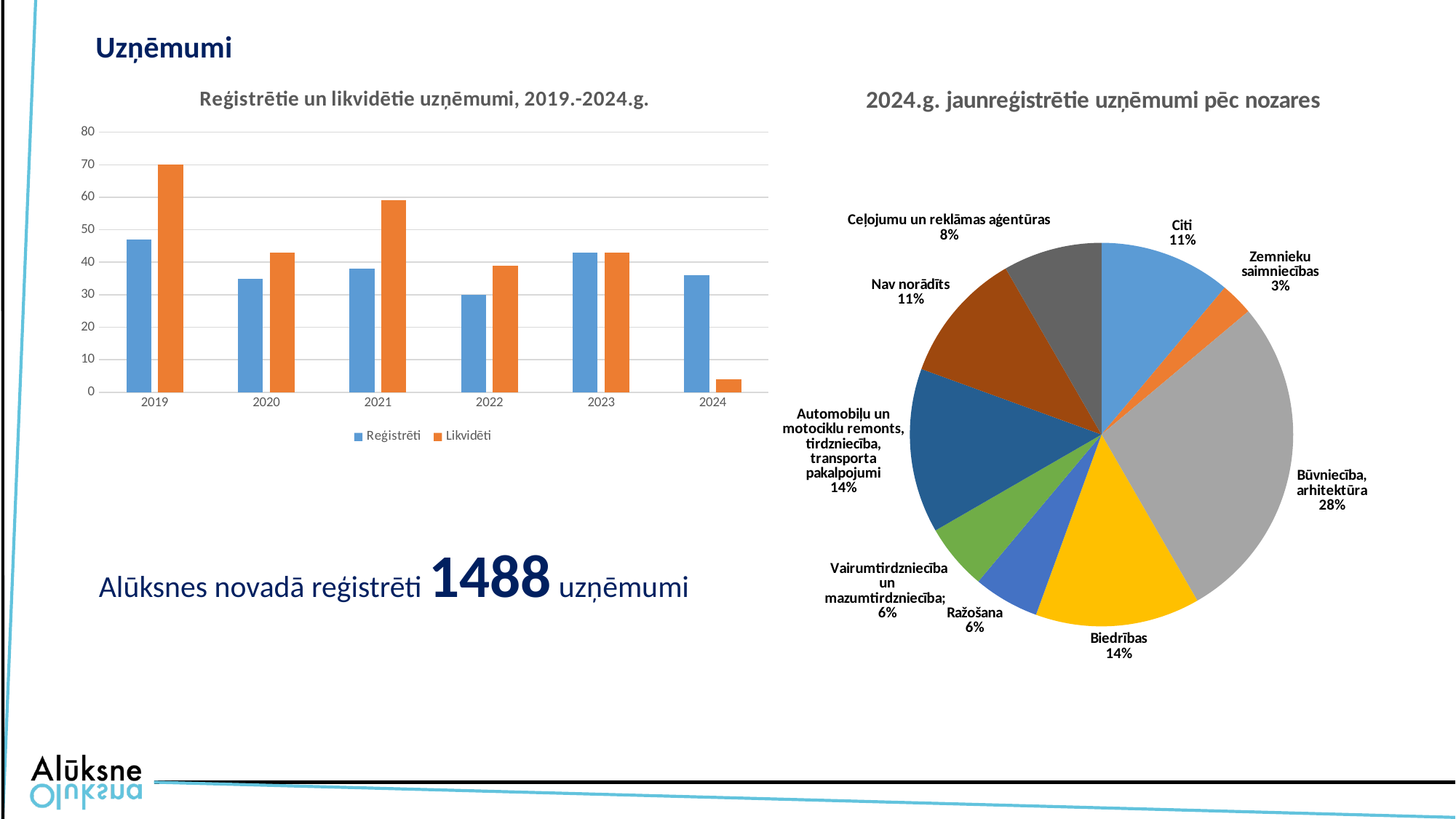
In the chart 'Reģistrētie un likvidētie uzņēmumi, 2019.-2024.g.', how many series does the legend list? 2 In the chart '2024.g. jaunreģistrētie uzņēmumi pēc nozares', which sector has the smallest share? Zemnieku saimniecības In the chart '2024.g. jaunreģistrētie uzņēmumi pēc nozares', what share does Būvniecība, arhitektūra have? 28% In the chart '2024.g. jaunreģistrētie uzņēmumi pēc nozares', what is the difference between the shares of Biedrības and Ražošana? 8% In the chart '2024.g. jaunreģistrētie uzņēmumi pēc nozares', how many slices does the pie have? 9 In the chart 'Reģistrētie un likvidētie uzņēmumi, 2019.-2024.g.', is the Likvidēti value for 2021 greater or less than 50? greater In the chart 'Reģistrētie un likvidētie uzņēmumi, 2019.-2024.g.', which year has the highest Likvidēti value? 2019 In the chart 'Reģistrētie un likvidētie uzņēmumi, 2019.-2024.g.', is the Reģistrēti value for 2022 greater or less than 40? less In the chart 'Reģistrētie un likvidētie uzņēmumi, 2019.-2024.g.', what kind of chart is it? Bar chart In the chart 'Reģistrētie un likvidētie uzņēmumi, 2019.-2024.g.', which year has the lowest Likvidēti value? 2024 In the chart 'Reģistrētie un likvidētie uzņēmumi, 2019.-2024.g.', how many years are shown on the x axis? 6 In the chart 'Reģistrētie un likvidētie uzņēmumi, 2019.-2024.g.', which is larger for 2024: Reģistrēti or Likvidēti? Reģistrēti